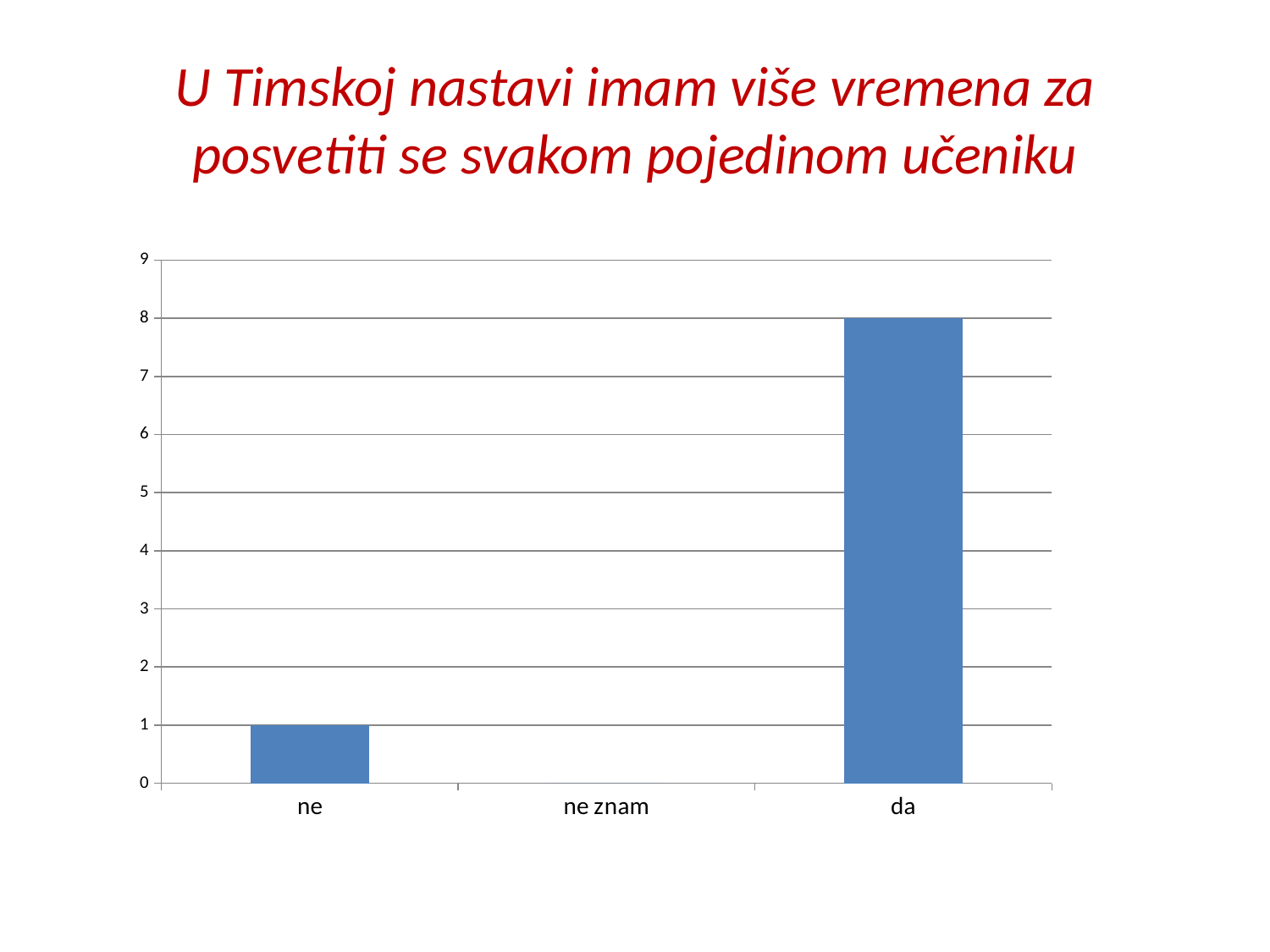
Which category has the highest value? da What is the difference between the values for "da" and "ne"? 7 What is the value for "ne znam"? 0 Is the value for "da" greater or less than 5? greater What is the value for "da"? 8 Which is larger, the value for "ne" or the value for "da"? da Which category has the lowest value? ne znam What is the value for "ne"? 1 What is the highest value shown on the y axis? 9 How many categories are shown on the x axis of the chart? 3 What colour are the bars in the chart? blue What type of chart is shown on the slide? bar chart